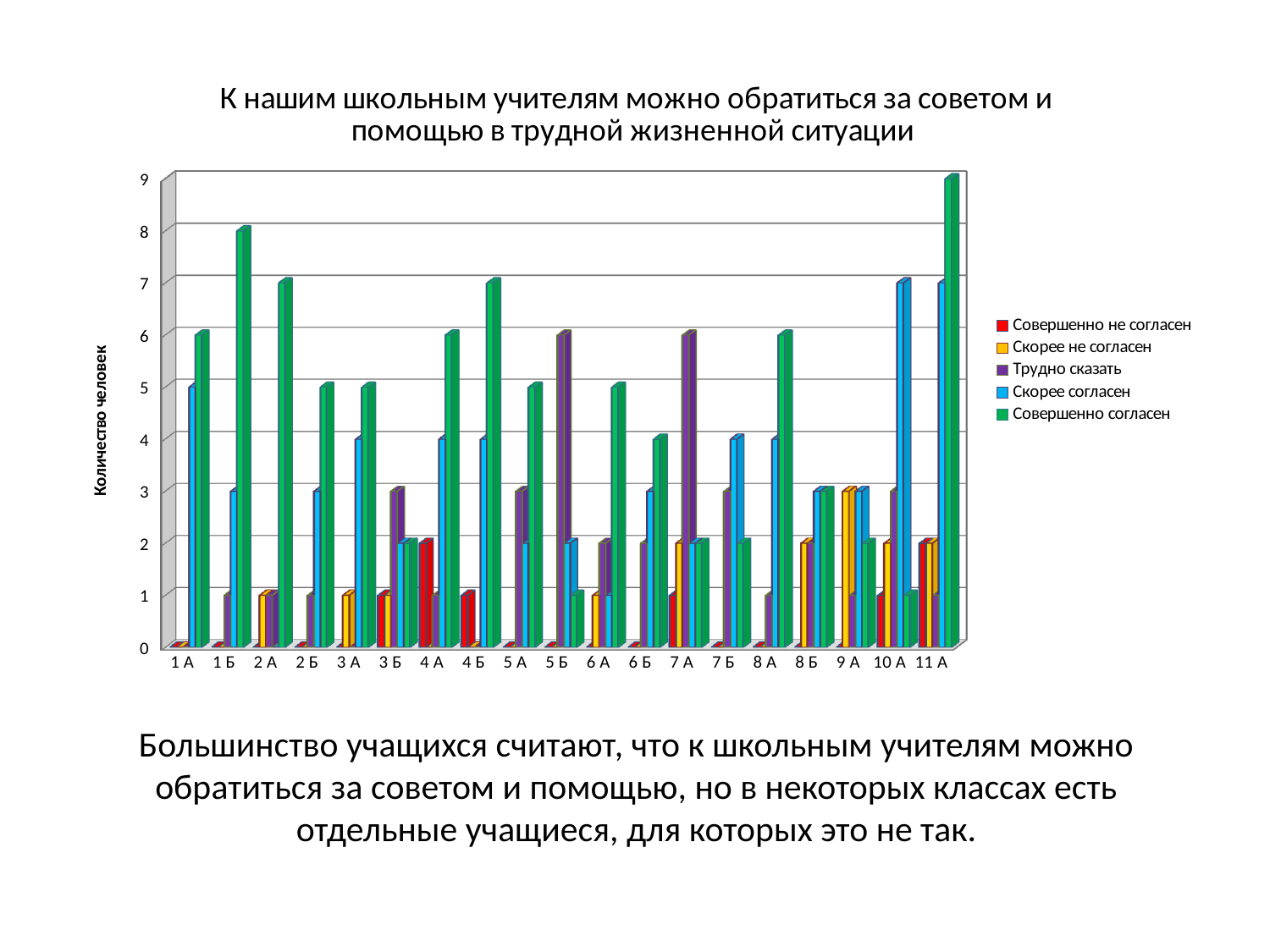
Is the value for "Скорее согласен" in class 10 А greater or less than 6? greater Is the value for "Совершенно согласен" in class 1 Б greater or less than 7? greater Which series is shown in green in the legend? Совершенно согласен In class 5 Б, which is larger: the value for "Трудно сказать" or the value for "Совершенно согласен"? Трудно сказать Is the value for "Трудно сказать" in class 5 Б greater or less than 5? greater In class 1 Б, which is larger: the value for "Совершенно согласен" or the value for "Скорее согласен"? Совершенно согласен What is the label of the vertical axis? Количество человек What kind of chart is shown on the slide? bar chart How many series does the legend list? 5 How many classes (categories) are shown along the x axis? 19 Which class has the highest value for the series "Совершенно согласен"? 11 А